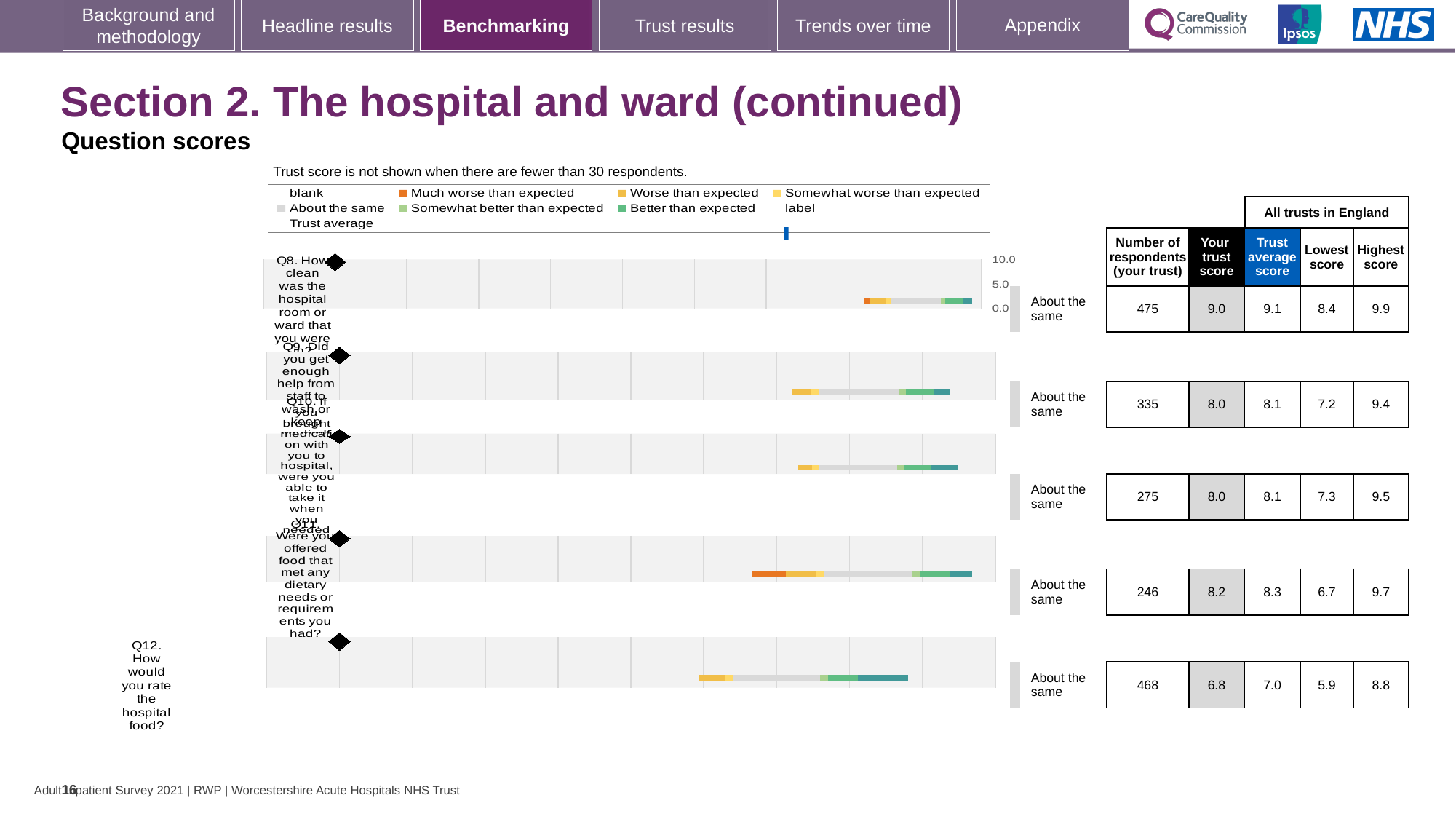
What is the lowest score across all trusts in England for Q11 (were you offered food that met any dietary needs)? 6.7 What is the highest score across all trusts in England for Q9 (did you get enough help from staff to wash or keep yourself clean)? 9.4 What kind of chart is used to show the question scores on this slide? bar chart For Q8, what is the difference between the highest score (9.9) and the lowest score (8.4) across all trusts in England? 1.5 In the table next to the chart, how many respondents are shown for Q12 (how would you rate the hospital food)? 468 For Q11, which is larger: your trust score or the trust average score? Trust average score How many questions (Q8 to Q12) are plotted in the question scores chart? 5 Which question has the lowest 'Your trust score' in the table? Q12 In the table next to the chart, what is the 'Your trust score' for Q8 (how clean was the hospital room or ward)? 9.0 What benchmark category label is shown beside every question in the chart? About the same Which question has the highest 'Your trust score' in the table? Q8 For Q12, what is the difference between the trust average score (7.0) and your trust score (6.8)? 0.2